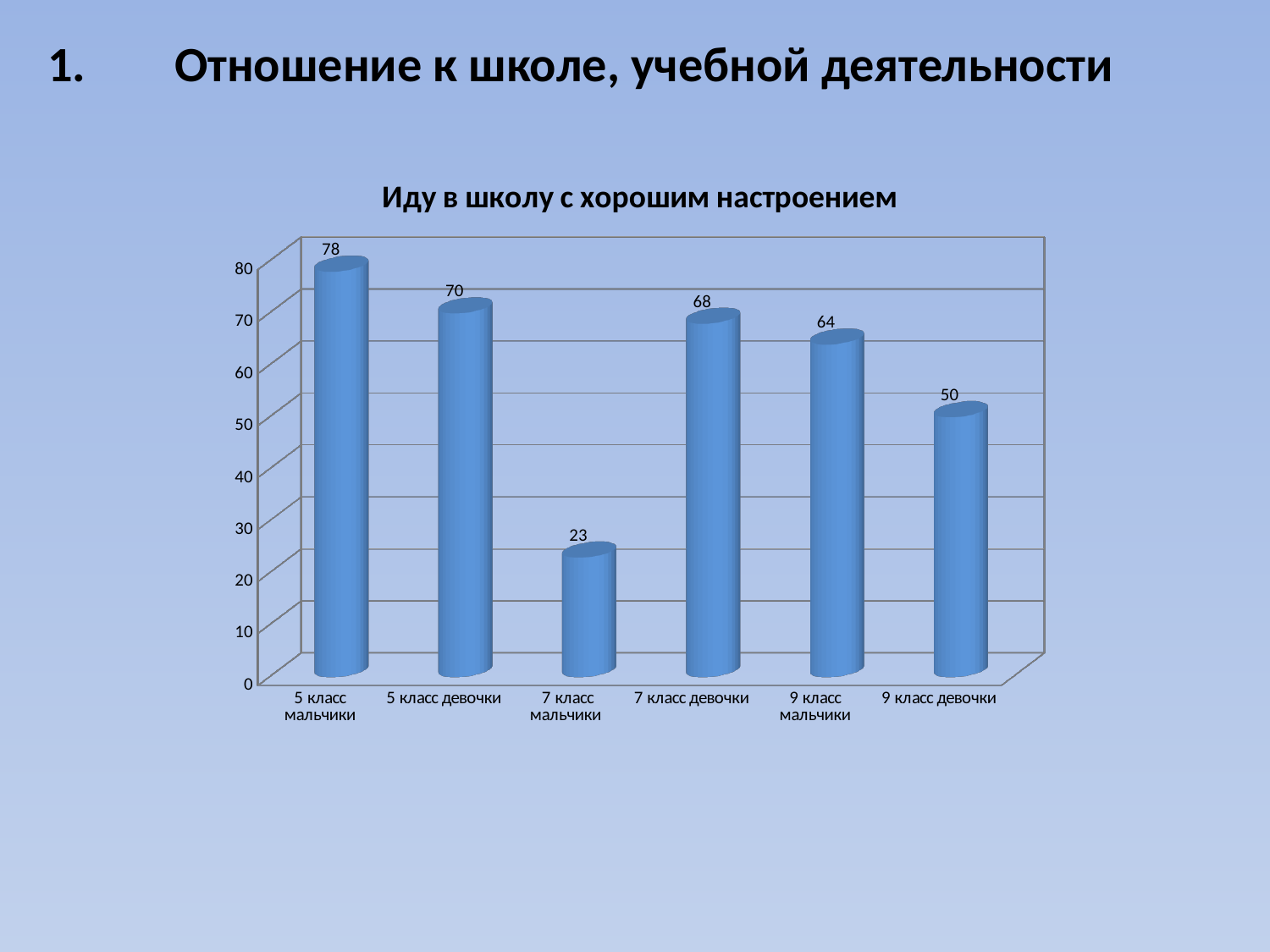
What is the value for 5 класс мальчики? 78 Which category has the highest value? 5 класс мальчики What is the value for 7 класс мальчики? 23 How many categories are shown on the x axis? 6 What is the difference between the values for 9 класс мальчики and 9 класс девочки? 14 Which is larger, the value for 7 класс девочки or the value for 9 класс мальчики? 7 класс девочки What is the difference between the values for 5 класс девочки and 7 класс девочки? 2 What is the value for 9 класс девочки? 50 Which category has the lowest value? 7 класс мальчики Is the value for 7 класс мальчики greater or less than 30? less What kind of chart is shown on the slide? bar chart What is the title of the chart? Иду в школу с хорошим настроением